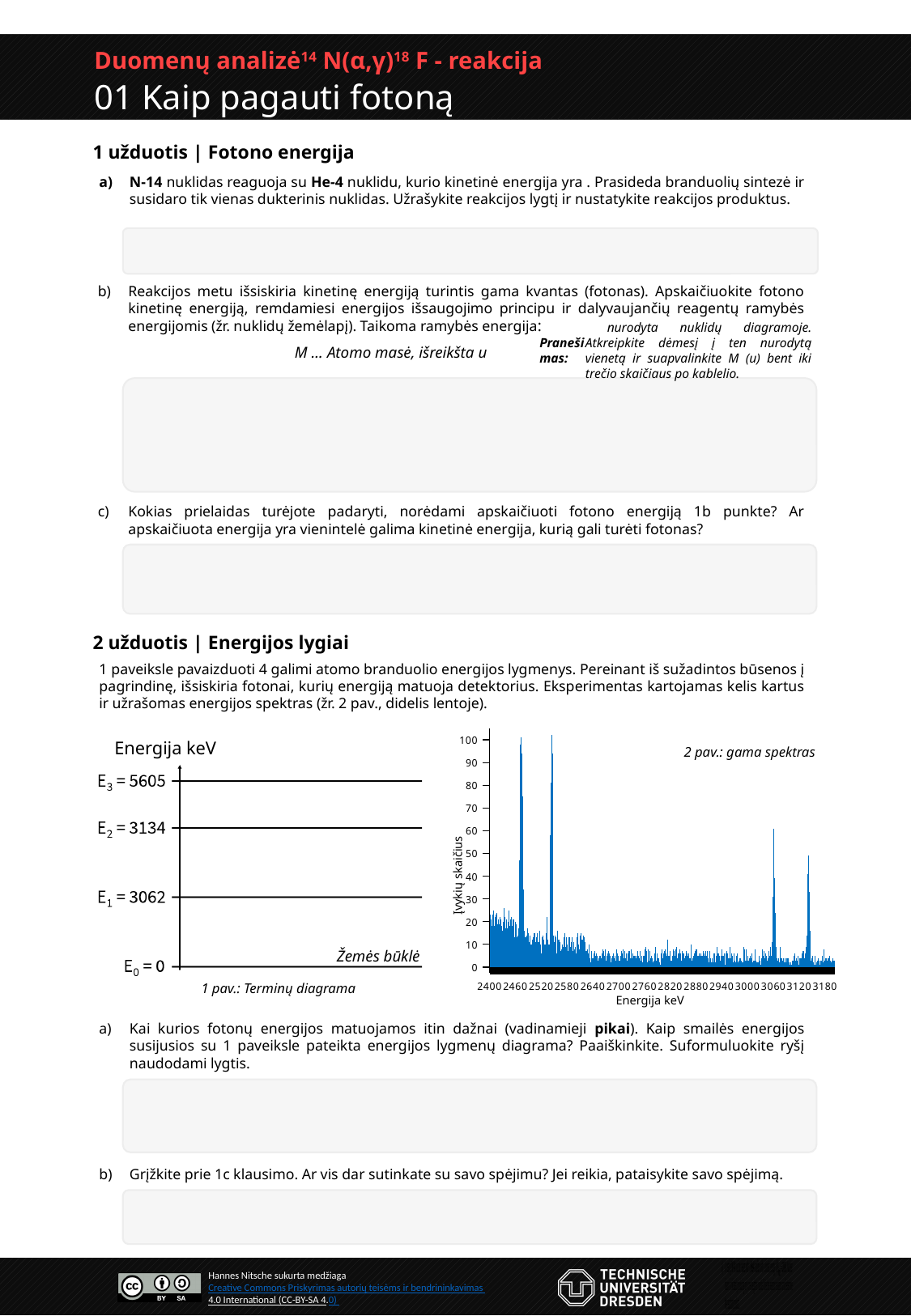
In the diagram titled '1 pav.: Terminų diagrama', what is the value of E1? 3062 In the chart titled '2 pav.: gama spektras', what kind of chart is shown? bar chart In the diagram titled '1 pav.: Terminų diagrama', what is the value of E3? 5605 In the chart titled '2 pav.: gama spektras', is the height of the peak near 3060 keV greater or less than 50? greater In the diagram titled '1 pav.: Terminų diagrama', what is the difference between E2 and E1? 72 In the diagram titled '1 pav.: Terminų diagrama', how many energy levels are shown? 4 In the chart titled '2 pav.: gama spektras', is the peak near 2460 keV taller or shorter than the peak near 3060 keV? taller In the chart titled '2 pav.: gama spektras', is the height of the tallest peak near 2460 keV greater or less than 90? greater In the diagram titled '1 pav.: Terminų diagrama', what is the value of E2? 3134 In the chart titled '2 pav.: gama spektras', is the height of the peak near 3120 keV greater or less than 70? less In the chart titled '2 pav.: gama spektras', what is the label of the x axis? Energija keV In the chart titled '2 pav.: gama spektras', what is the label of the y axis? Įvykių skaičius